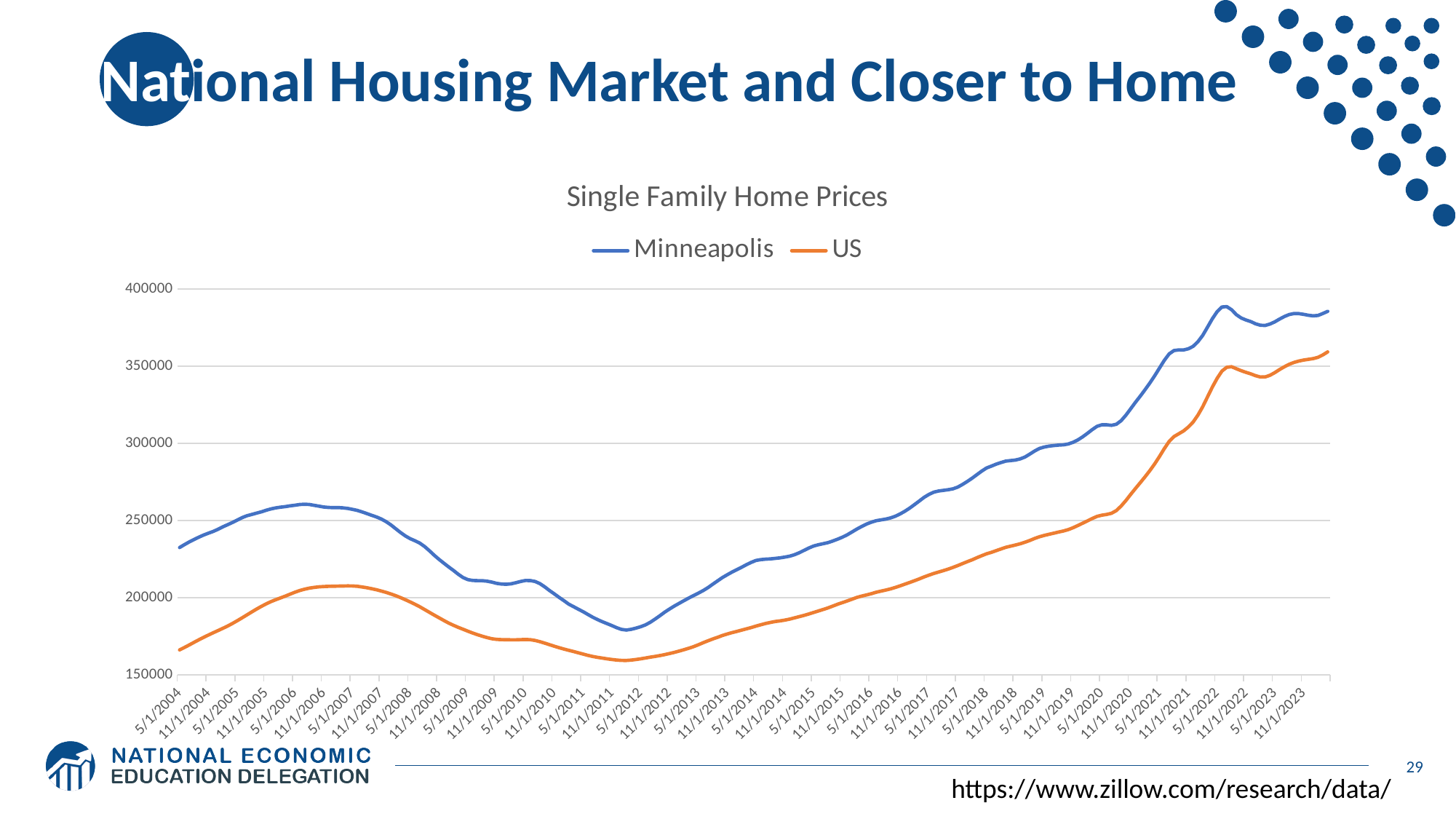
What kind of chart is shown on the slide? line chart How many series does the legend list? 2 Which series reaches the highest value on the chart? Minneapolis What is the title of the chart? Single Family Home Prices Is the Minneapolis value at 11/1/2023 greater or less than 400000? less Is the US value at 11/1/2023 greater or less than 300000? greater Which series is drawn in orange? US Is the Minneapolis value at 5/1/2004 greater or less than 200000? greater Which series has the higher value at 5/1/2022, Minneapolis or US? Minneapolis Does the Minneapolis line rise or fall between 5/1/2012 and 5/1/2022? rise